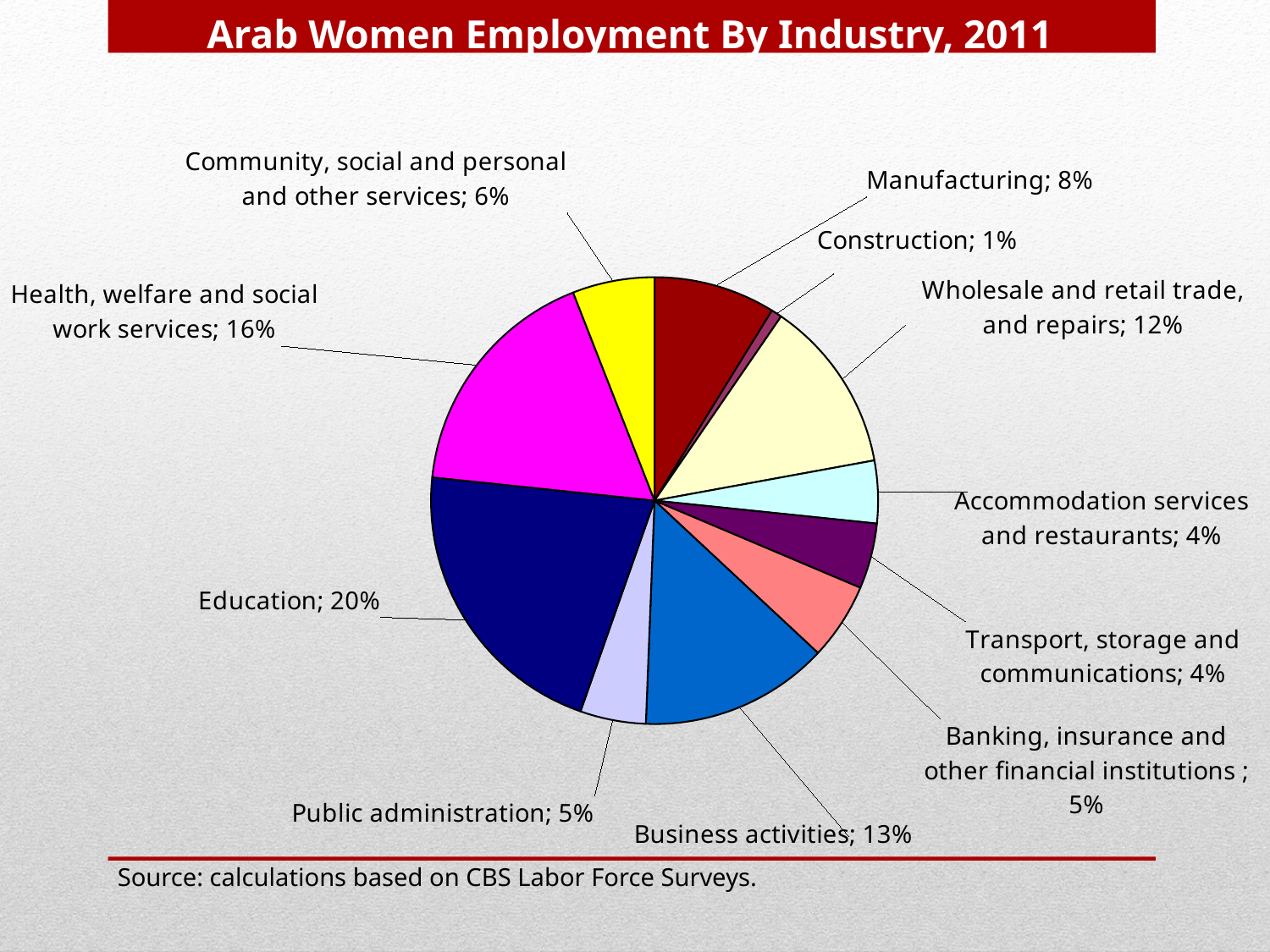
What percentage is shown for Construction? 1% Which industry has the largest share of the pie? Education What is the difference in percentage points between Education and Health, welfare and social work services? 4 What share of Arab women employment is in Education? 20% What percentage is shown for Health, welfare and social work services? 16% What percentage is shown for Business activities? 13% How many industry slices does the pie chart have? 11 Which is larger, the share for Manufacturing or the share for Wholesale and retail trade, and repairs? Wholesale and retail trade, and repairs Which industry has the smallest share of the pie? Construction What is the title of the chart? Arab Women Employment By Industry, 2011 What is the source cited below the chart? calculations based on CBS Labor Force Surveys What type of chart is shown on the slide? pie chart